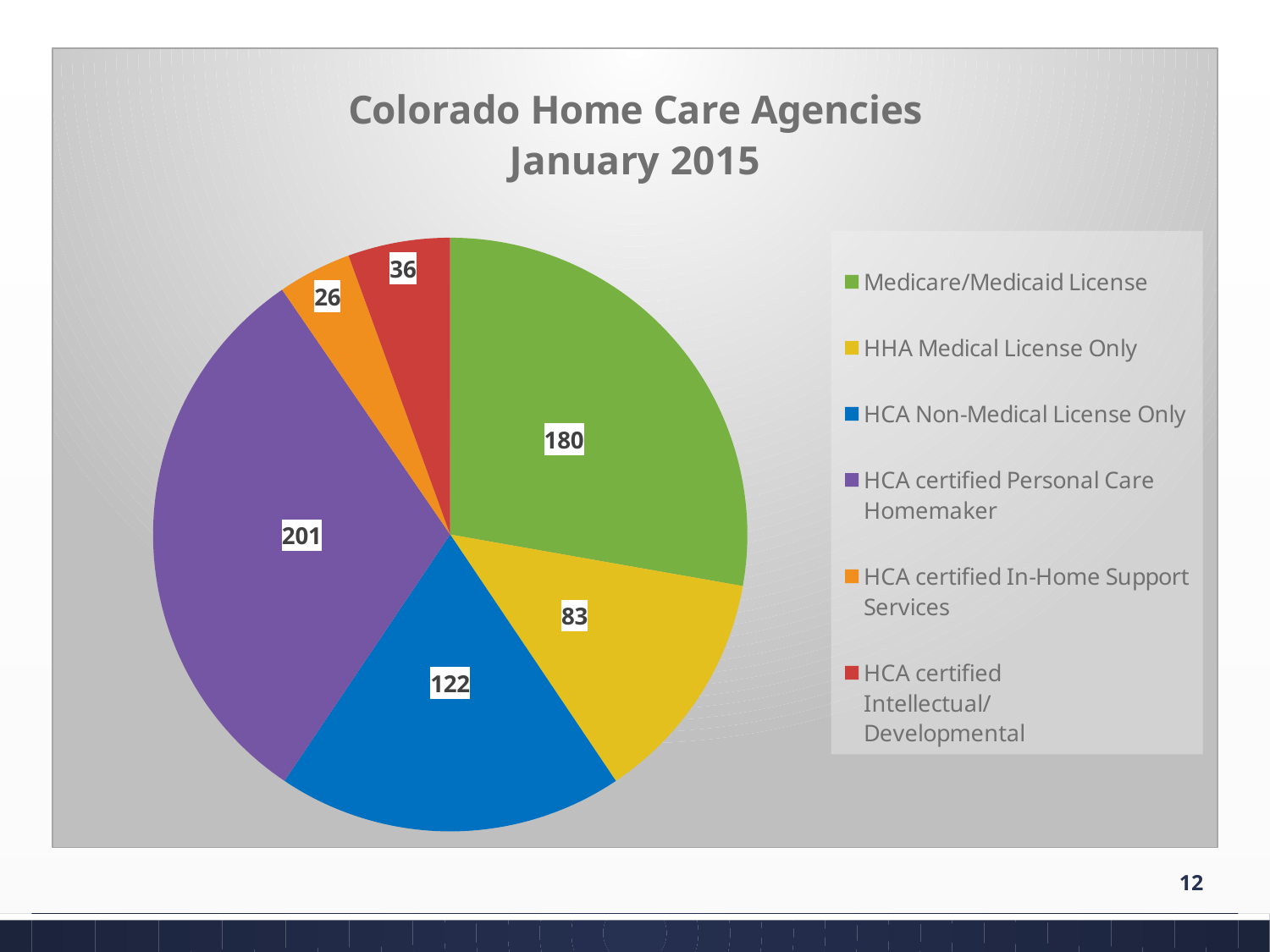
What type of chart is shown on the slide? Pie chart Which category has the smallest slice of the pie? HCA certified In-Home Support Services What is the value for Medicare/Medicaid License? 180 How many categories does the legend list? 6 What is the value for HCA certified Personal Care Homemaker? 201 What colour is the slice for HCA Non-Medical License Only? Blue What is the title of the chart? Colorado Home Care Agencies January 2015 What is the total of all the values shown in the pie chart? 648 What is the difference between the values for HCA Non-Medical License Only and HHA Medical License Only? 39 Which is larger, the value for HCA certified Intellectual/Developmental or the value for HCA certified In-Home Support Services? HCA certified Intellectual/Developmental What is the value for HCA certified In-Home Support Services? 26 Which category has the largest slice of the pie? HCA certified Personal Care Homemaker